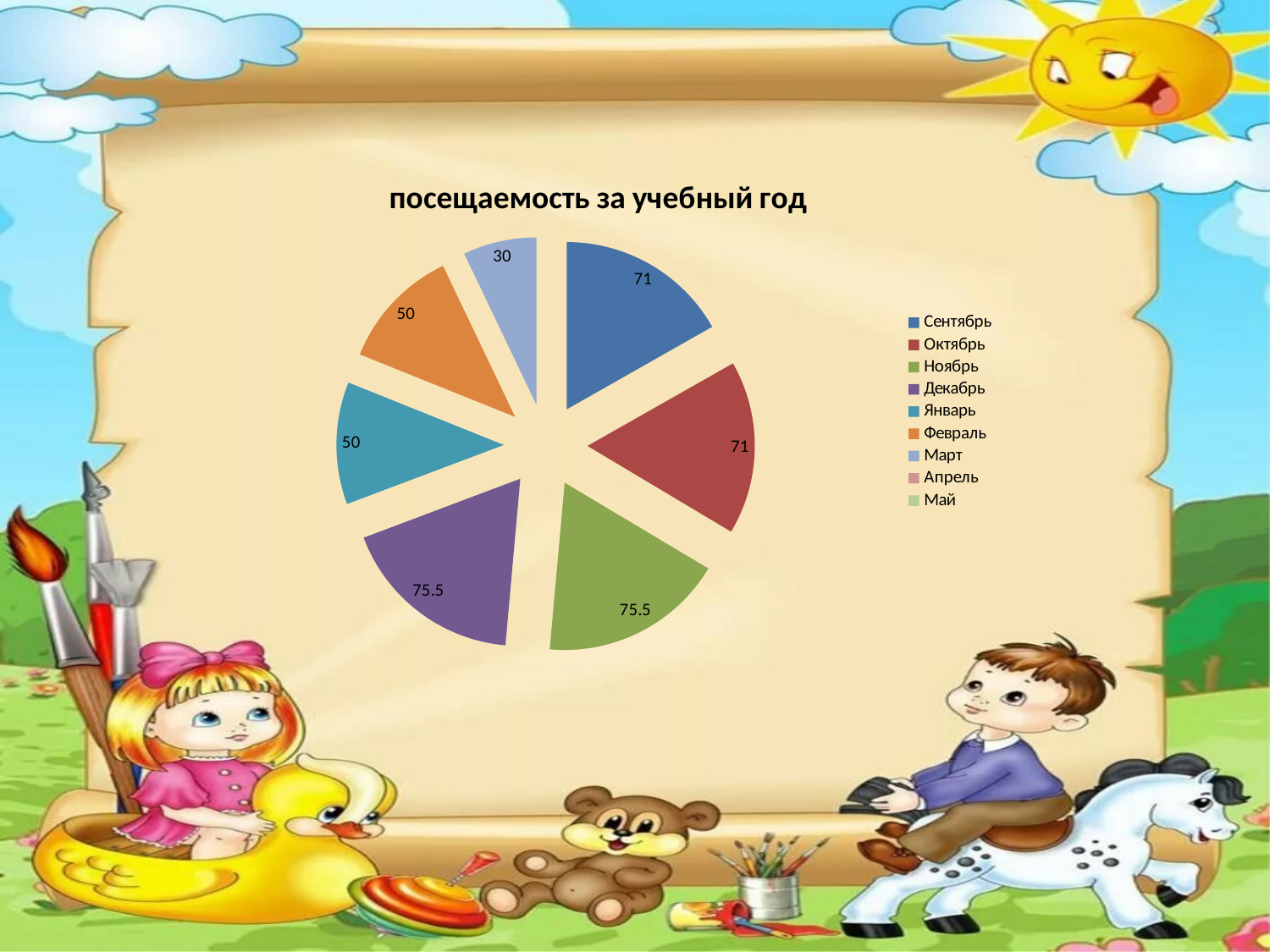
What is the value for Март? 30 What is the value for Сентябрь? 71 What kind of chart is shown on the slide? pie chart Which month has the smallest labelled slice in the pie chart? Март Which is larger, the value for Октябрь or the value for Январь? Октябрь What is the difference between the values for Декабрь and Март? 45.5 What is the value for Ноябрь? 75.5 What is the value for Январь? 50 How many entries does the legend list? 9 How many slices with data labels are shown in the pie chart? 7 What is the title of the chart? посещаемость за учебный год What is the difference between the values for Ноябрь and Февраль? 25.5